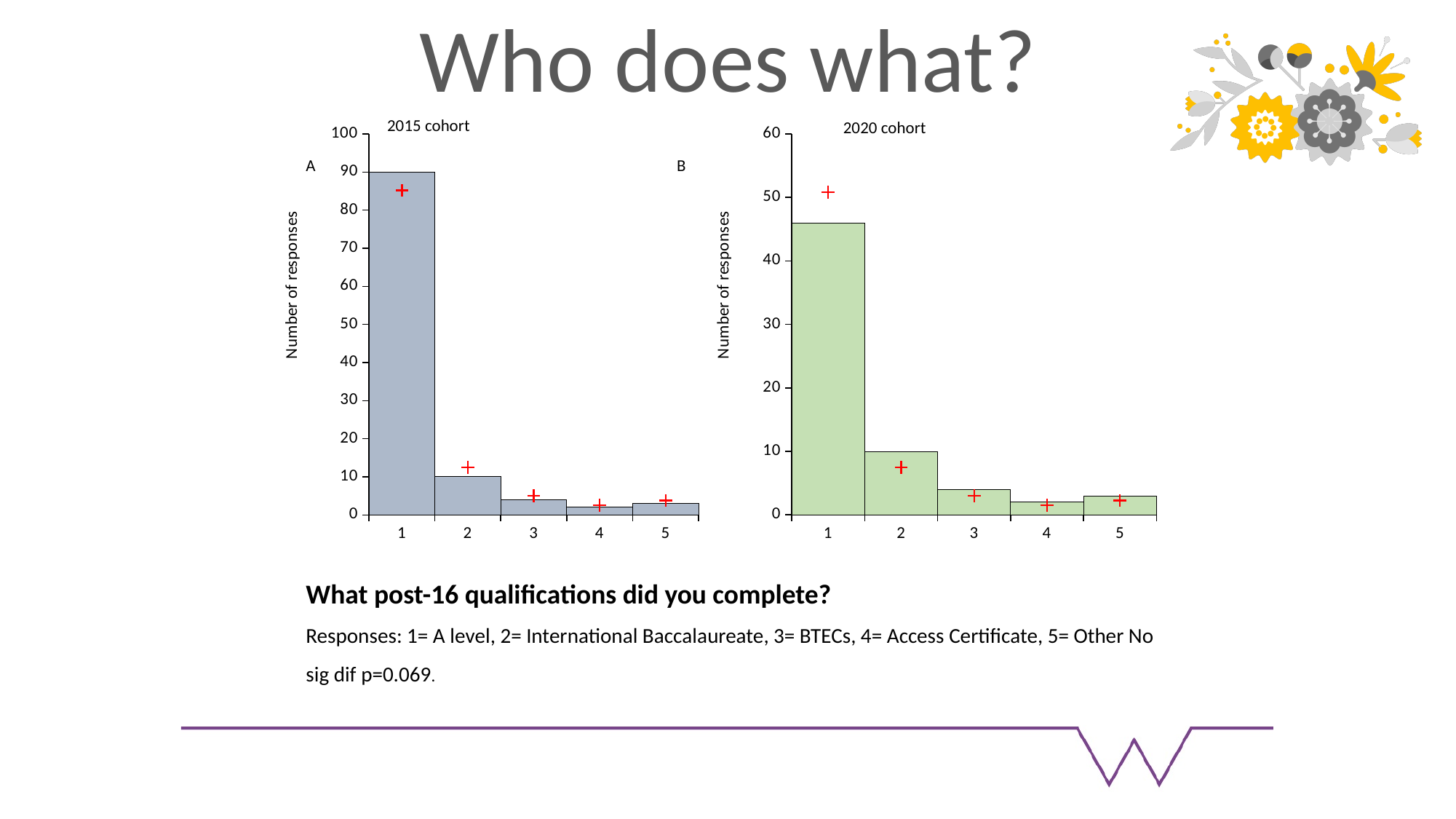
In the 2020 cohort chart, is the value for category 1 greater or less than 40? greater Which chart has the larger value for category 1, the 2015 cohort or the 2020 cohort? 2015 cohort How many categories are shown on the x axis of the 2020 cohort chart? 5 In the 2015 cohort chart, which category has the highest number of responses? 1 What kind of chart is the 2015 cohort chart? bar chart In the 2020 cohort chart, what is the number of responses for category 2? 10 What is the y-axis label on the 2020 cohort chart? Number of responses In the 2015 cohort chart, what is the difference in responses between category 1 and category 2? 80 In the 2020 cohort chart, which category has the highest number of responses? 1 In the 2015 cohort chart, what is the number of responses for category 1? 90 In the 2015 cohort chart, is the value for category 3 greater or less than 10? less In the 2015 cohort chart, what is the number of responses for category 2? 10